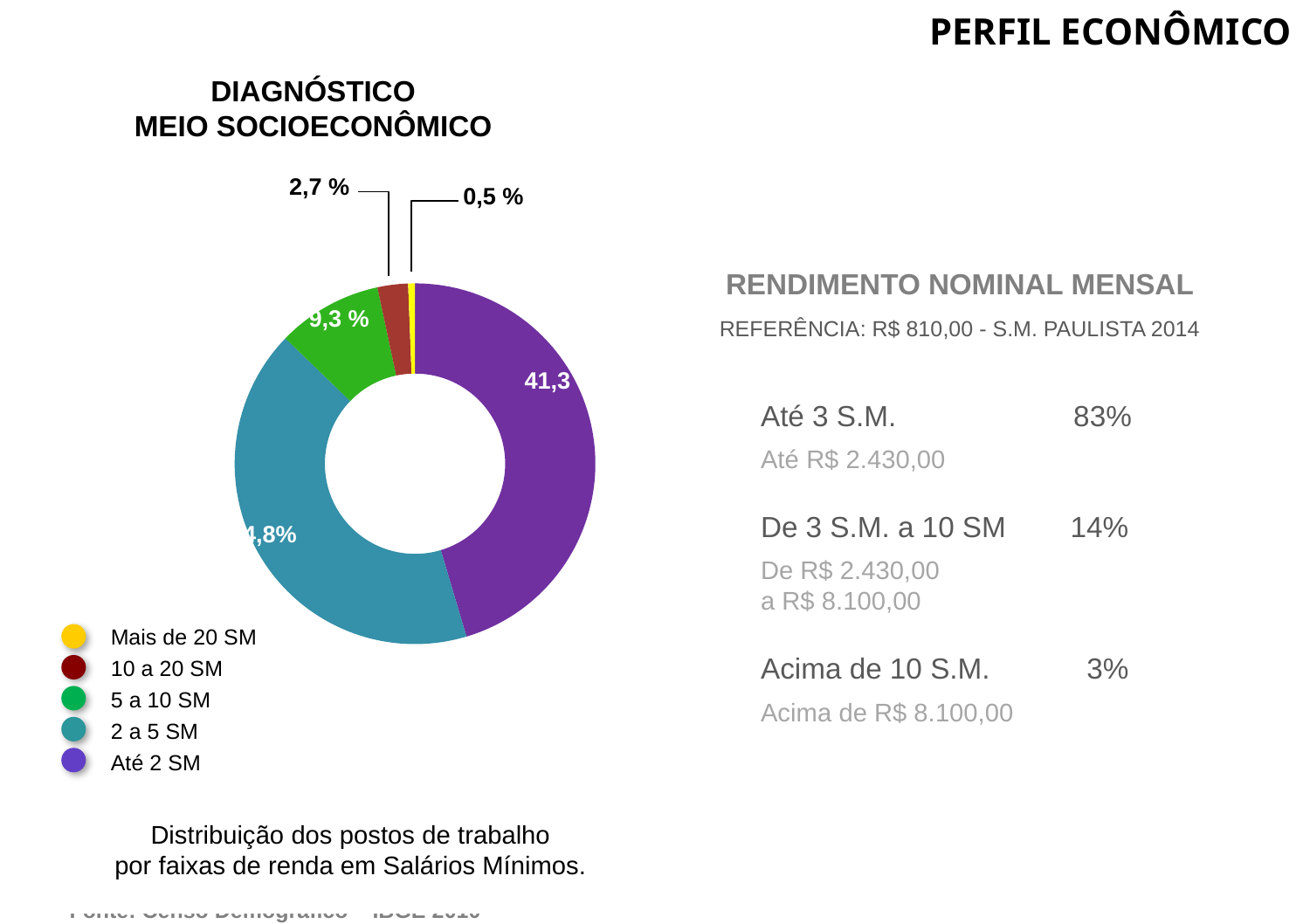
Which slice is larger in the pie chart: Até 2 SM or 5 a 10 SM? Até 2 SM How many categories does the legend of the pie chart list? 5 What is the difference in percentage points between the 10 a 20 SM slice and the Mais de 20 SM slice? 2,2 % What percentage of the pie chart is labelled for the 5 a 10 SM category? 9,3 % Which category has the smallest slice in the pie chart? Mais de 20 SM What is the difference in percentage points between the 5 a 10 SM slice and the 10 a 20 SM slice? 6,6 % What value is shown for the Mais de 20 SM slice of the pie chart? 0,5 % What value is shown for the 10 a 20 SM slice of the pie chart? 2,7 % What value is printed on the Até 2 SM slice of the pie chart? 41,3 What kind of chart is shown on the slide? Doughnut chart What colour represents the Até 2 SM category in the pie chart? Purple Which slice is larger in the pie chart: 5 a 10 SM or 10 a 20 SM? 5 a 10 SM